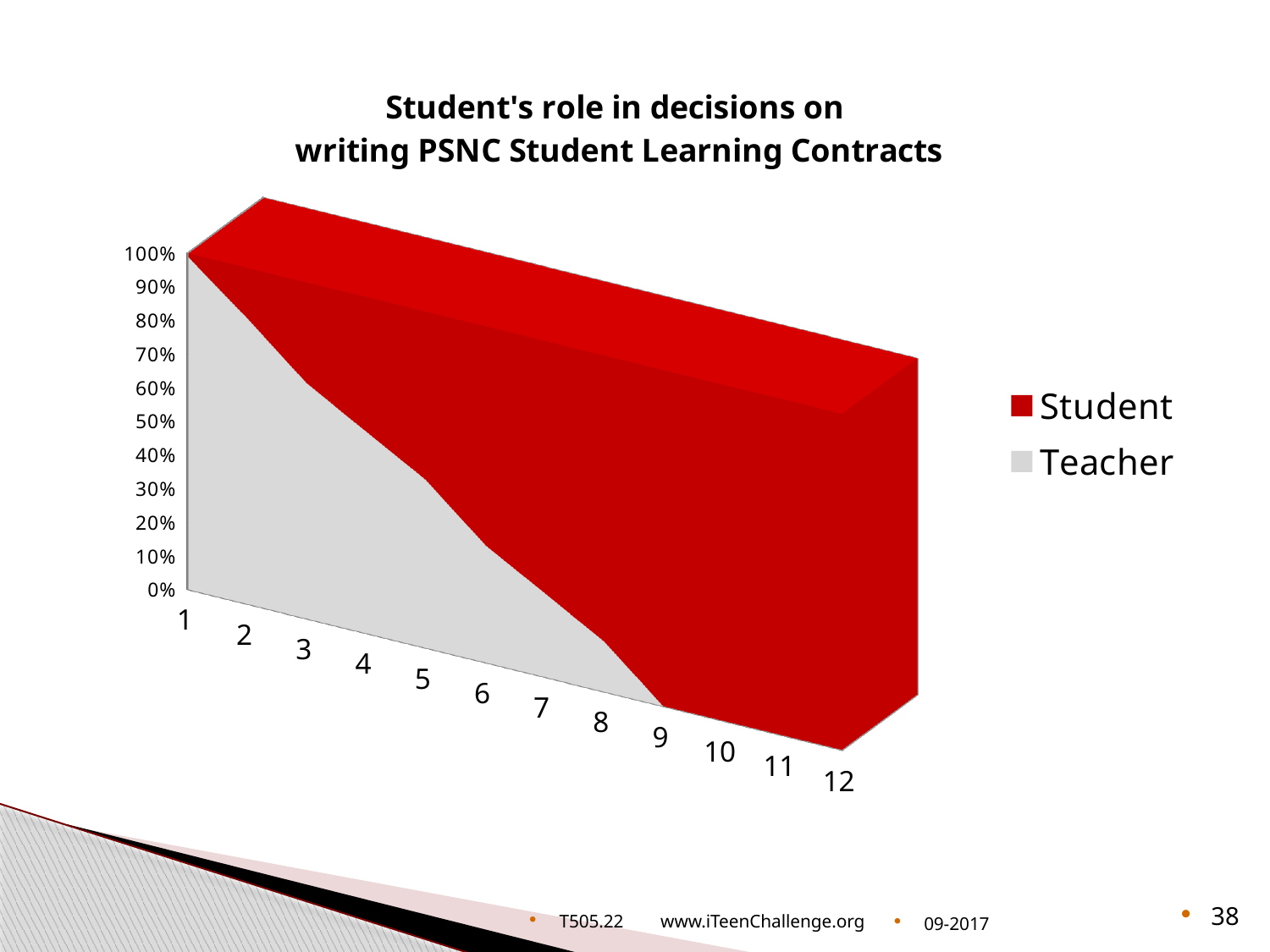
What is the Teacher value at category 12? 0% Is the Teacher value at category 7 greater or less than 50%? less At which category is the Teacher value highest? 1 What kind of chart is shown on the slide? area chart At category 2, which series has the larger share, Student or Teacher? Teacher Does the Teacher series rise or fall as you move from category 1 to category 12? fall How many categories are shown along the x axis? 12 How many series does the legend list? 2 Does the Student series rise or fall as you move from category 1 to category 12? rise Which colour represents the Student series in the legend? red Is the Teacher value at category 3 greater or less than 50%? greater